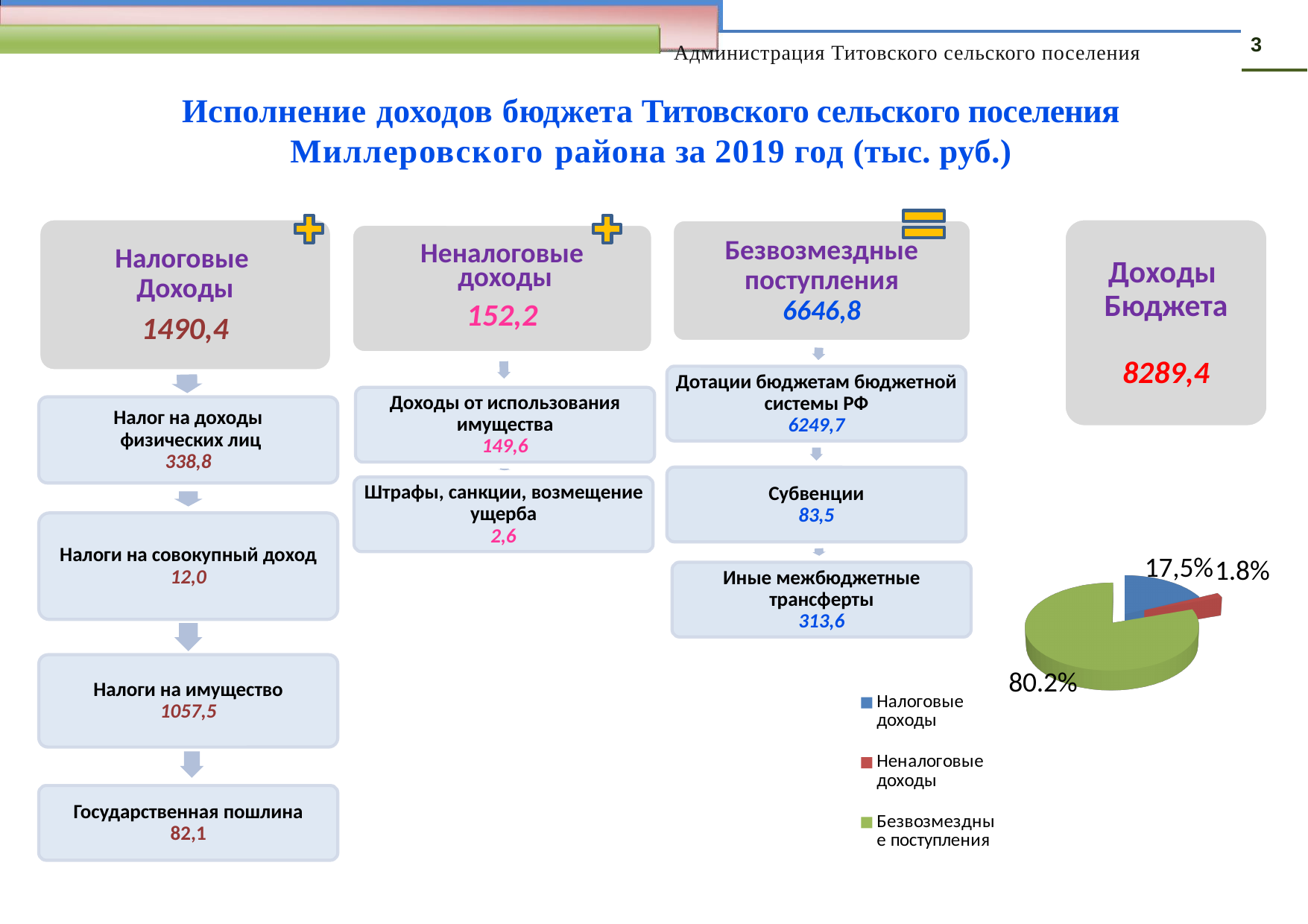
In the pie chart, what colour is the slice for Безвозмездные поступления? green What share of the pie chart is labelled for Неналоговые доходы? 1.8% In the pie chart, which is larger: Налоговые доходы or Неналоговые доходы? Налоговые доходы What share of the pie chart is labelled for Налоговые доходы? 17,5% How many slices does the pie chart have? 3 Which category has the smallest slice in the pie chart? Неналоговые доходы In the pie chart, what colour is the slice for Налоговые доходы? blue What share of the pie chart is labelled for Безвозмездные поступления? 80.2% What kind of chart is shown on the slide? pie chart How many entries does the pie chart's legend list? 3 Which category has the largest slice in the pie chart? Безвозмездные поступления